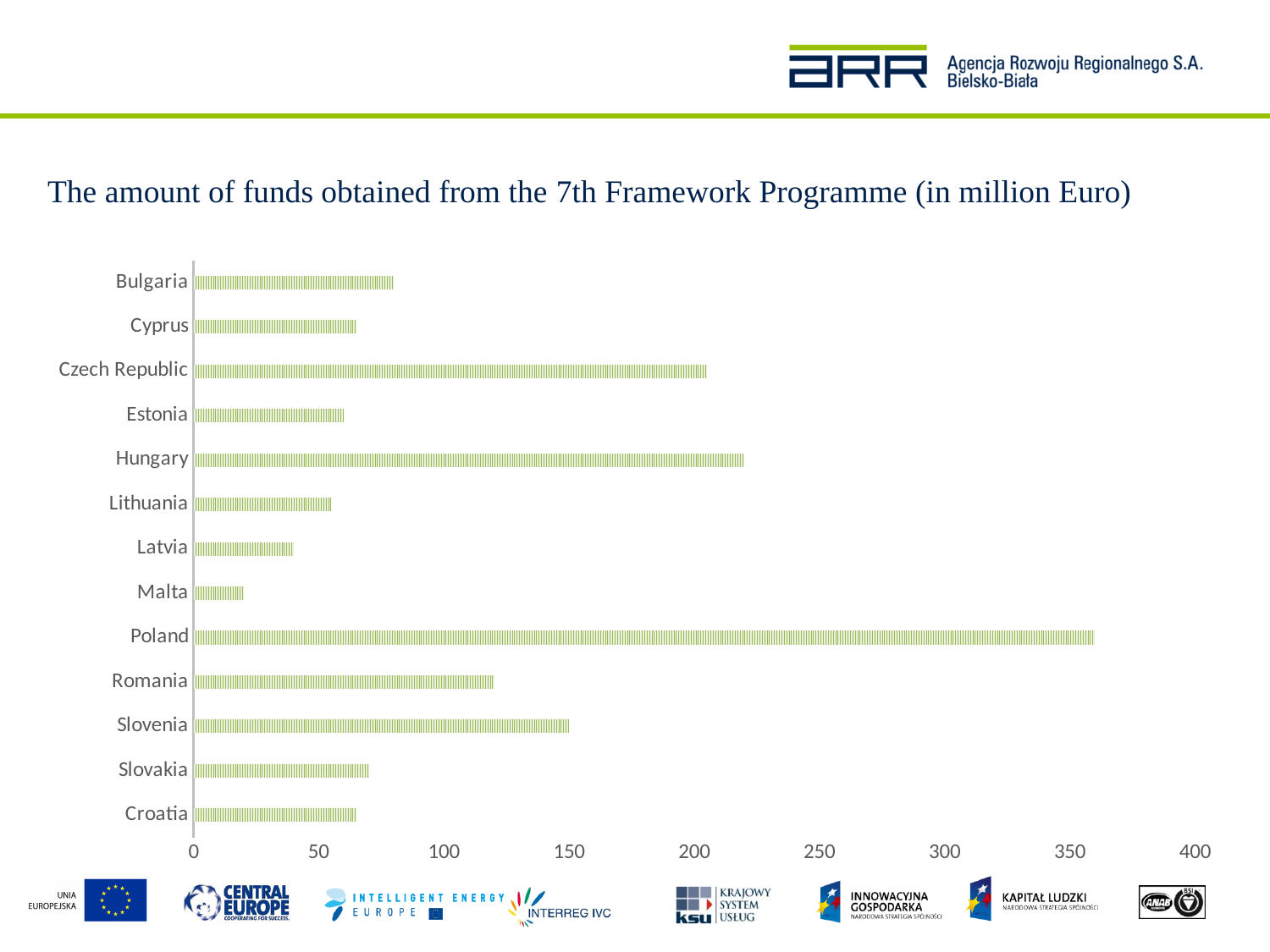
Which country obtained the highest amount of funds? Poland What type of chart is shown on the slide? bar chart How many countries are shown in the chart? 13 Is the value for Slovenia greater or less than 200? less Which country has the larger value, Bulgaria or Cyprus? Bulgaria Which country obtained the lowest amount of funds? Malta Which country has the larger value, Romania or Slovenia? Slovenia Is the value for Poland greater or less than 300? greater Is the value for Romania greater or less than 100? greater What is the title of the chart? The amount of funds obtained from the 7th Framework Programme (in million Euro)